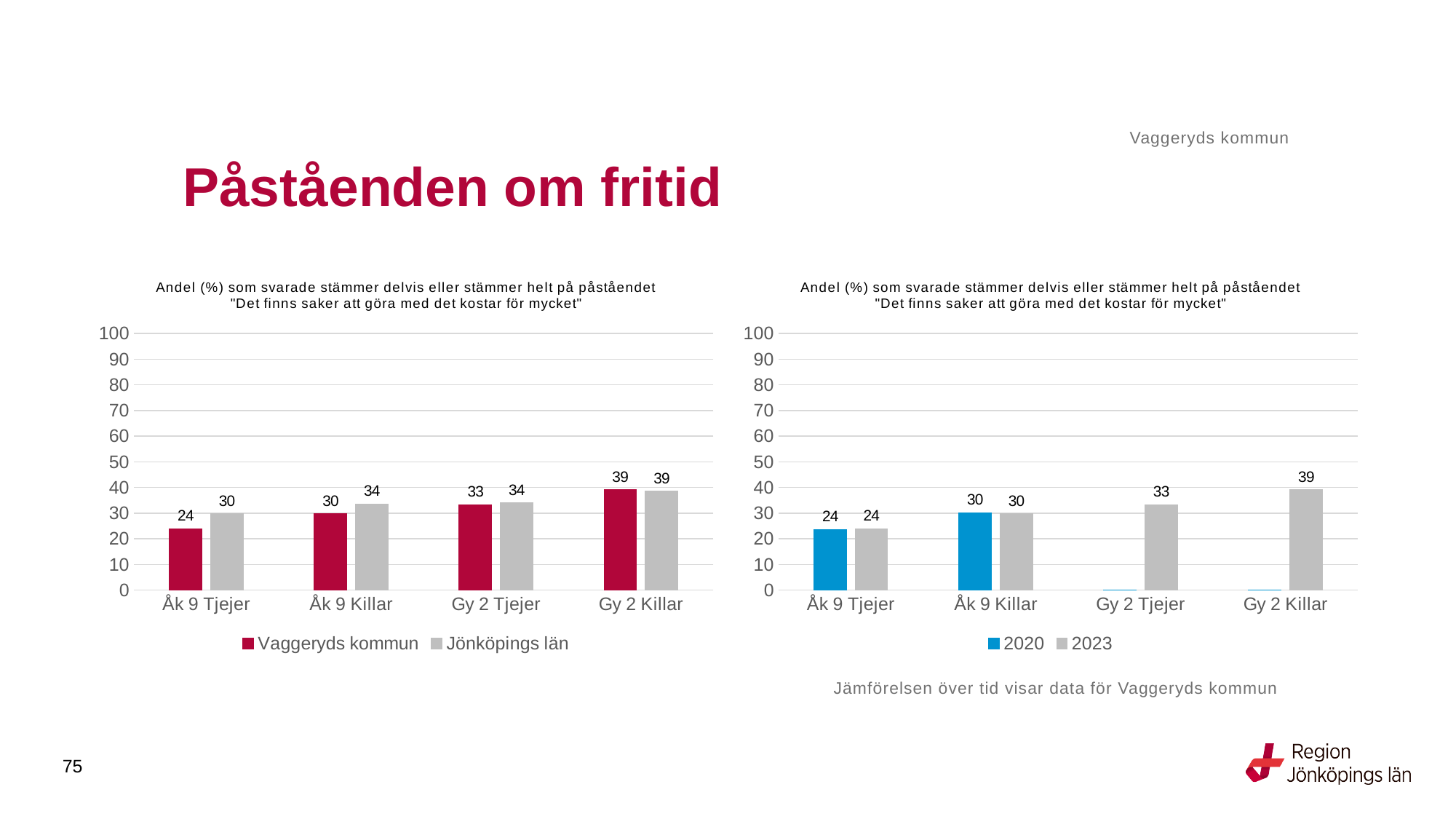
In the left chart, what is the value for Jönköpings län for Åk 9 Killar? 34 In the left chart, which is larger for Gy 2 Tjejer: Vaggeryds kommun or Jönköpings län? Jönköpings län In the left chart, what is the value for Vaggeryds kommun for Åk 9 Tjejer? 24 In the right chart, how many categories are shown on the x axis? 4 In the left chart, which category has the highest value for Vaggeryds kommun? Gy 2 Killar In the right chart, how many series does the legend list? 2 In the right chart, what is the value for 2020 for Åk 9 Killar? 30 In the right chart, do the 2023 values rise or fall from Åk 9 Tjejer to Gy 2 Killar? Rise What kind of chart is the left chart? Bar chart In the left chart, which category has the lowest value for Jönköpings län? Åk 9 Tjejer In the right chart, what is the value for 2023 for Gy 2 Killar? 39 In the left chart, what is the difference between Jönköpings län and Vaggeryds kommun for Åk 9 Tjejer? 6